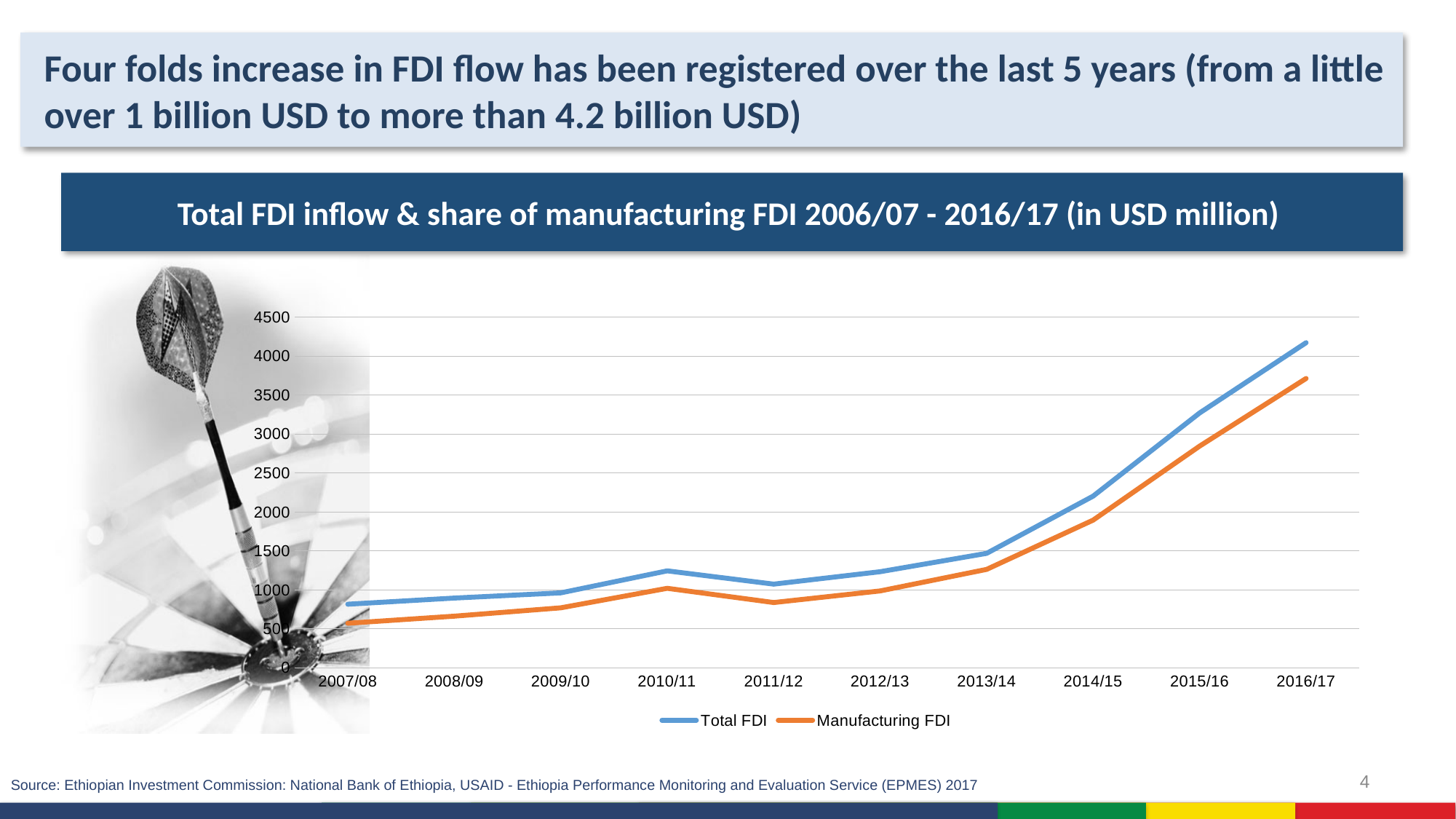
Does Total FDI rise or fall from 2013/14 to 2016/17? Rise How many fiscal years are plotted along the x axis? 10 Which is larger in 2010/11: Total FDI or Manufacturing FDI? Total FDI Which series is drawn in orange? Manufacturing FDI Is the value for Manufacturing FDI in 2015/16 greater or less than 3000? less What kind of chart is shown on the slide? Line chart Is the value for Total FDI in 2007/08 greater or less than 1000? less Is the value for Manufacturing FDI in 2016/17 greater or less than 3500? greater In which year is Total FDI highest? 2016/17 How many series does the legend list? 2 In which year is Manufacturing FDI lowest? 2007/08